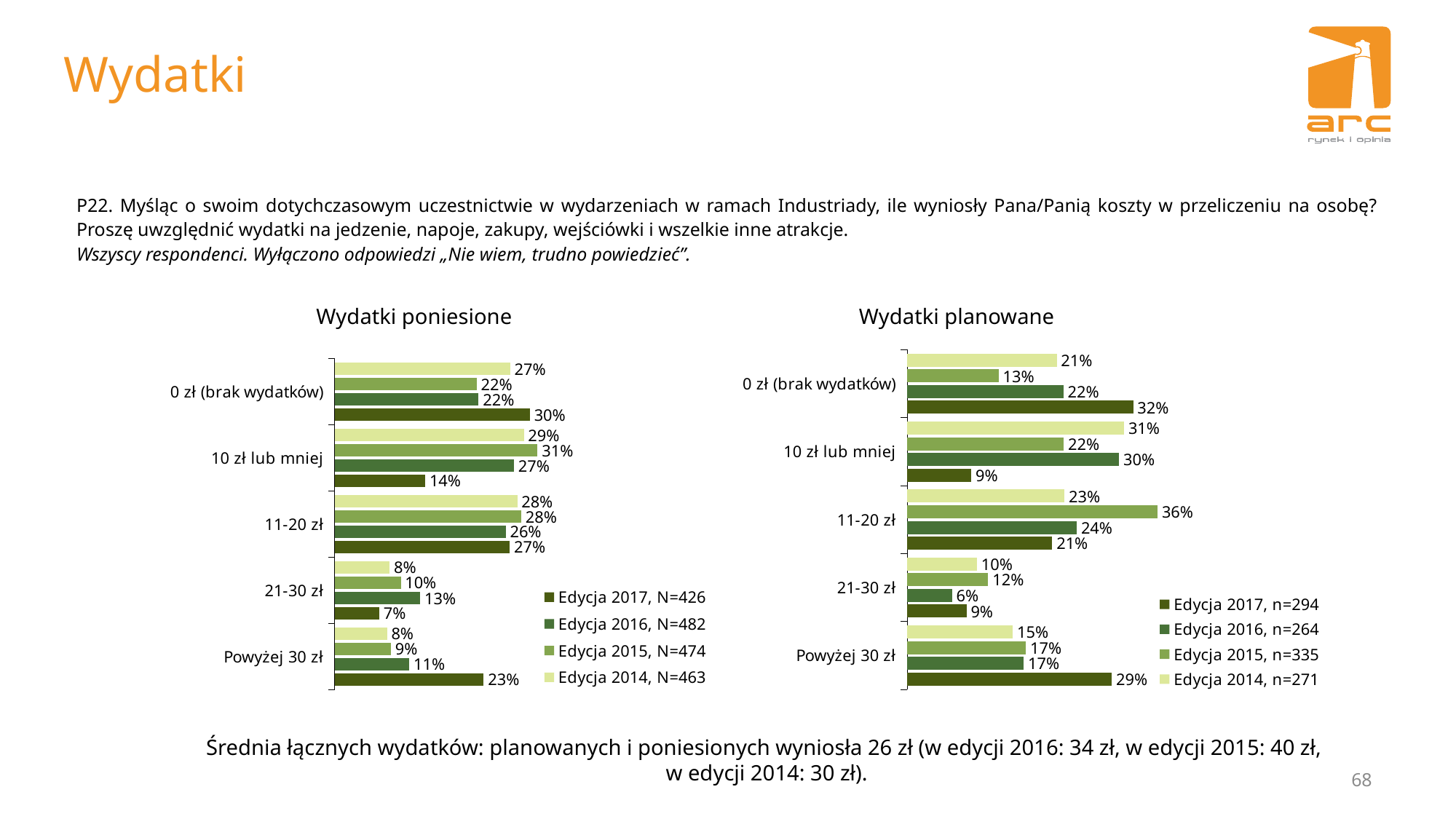
What type of chart is 'Wydatki planowane'? Bar chart In the 'Wydatki planowane' chart, which category has the highest value in the Edycja 2017 series? 0 zł (brak wydatków) In the 'Wydatki poniesione' chart, what is the value for 'Powyżej 30 zł' in the Edycja 2016 series? 11% In the 'Wydatki planowane' chart, what is the value for '11-20 zł' in the Edycja 2015 series? 36% In the 'Wydatki planowane' chart, what is the difference between the Edycja 2017 and Edycja 2014 values for 'Powyżej 30 zł'? 14 percentage points In the 'Wydatki poniesione' chart, which category has the lowest value in the Edycja 2014 series? 8% for both '21-30 zł' and 'Powyżej 30 zł' In the 'Wydatki planowane' chart, what is the difference between the Edycja 2017 and Edycja 2016 values for '10 zł lub mniej'? 21 percentage points How many series does the legend of the 'Wydatki poniesione' chart list? 4 In the 'Wydatki poniesione' chart, what is the value for '0 zł (brak wydatków)' in the Edycja 2017 series? 30% What sample size is given for Edycja 2016 in the legend of the 'Wydatki planowane' chart? n=264 In the 'Wydatki poniesione' chart, which is larger for '10 zł lub mniej': the Edycja 2015 value or the Edycja 2017 value? Edycja 2015 How many categories are shown in the 'Wydatki planowane' chart? 5